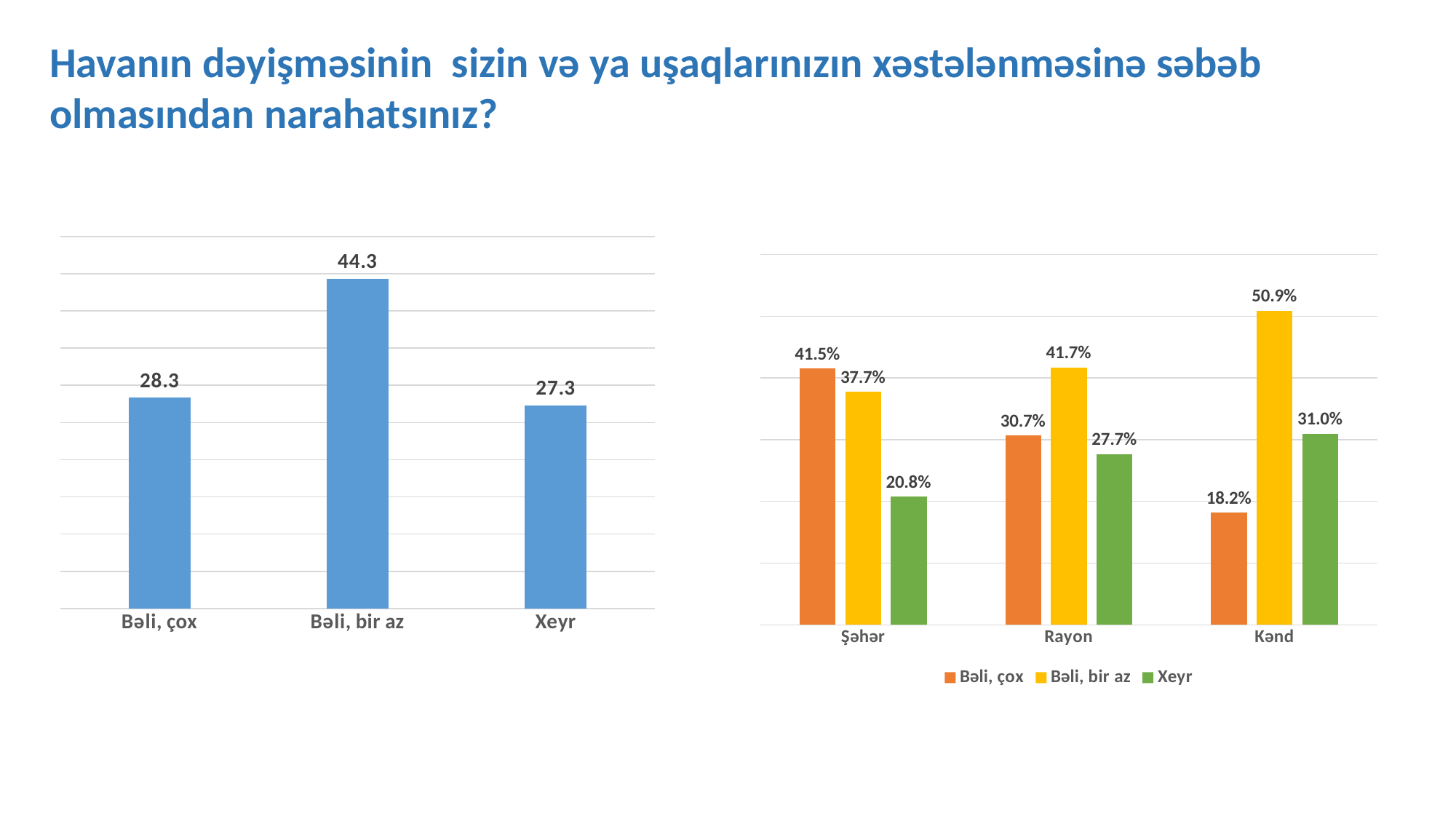
In the right chart, what is the value for "Xeyr" in Şəhər? 20.8% In the right chart, which is larger in Rayon: "Bəli, çox" or "Xeyr"? Bəli, çox In the right chart, what colour are the bars for "Bəli, bir az"? yellow In the left chart, which category has the lowest value? Xeyr In the left chart, how many categories are shown? 3 In the left chart, what is the difference between the values for "Bəli, bir az" and "Bəli, çox"? 16.0 In the right chart, what is the value for "Bəli, bir az" in Kənd? 50.9% In the right chart, which category has the lowest value for "Bəli, çox"? Kənd What kind of chart is the left chart? bar chart In the left chart, what is the value for "Bəli, bir az"? 44.3 In the right chart, what is the difference between "Bəli, bir az" and "Bəli, çox" in Kənd? 32.7% How many series does the legend of the right chart list? 3